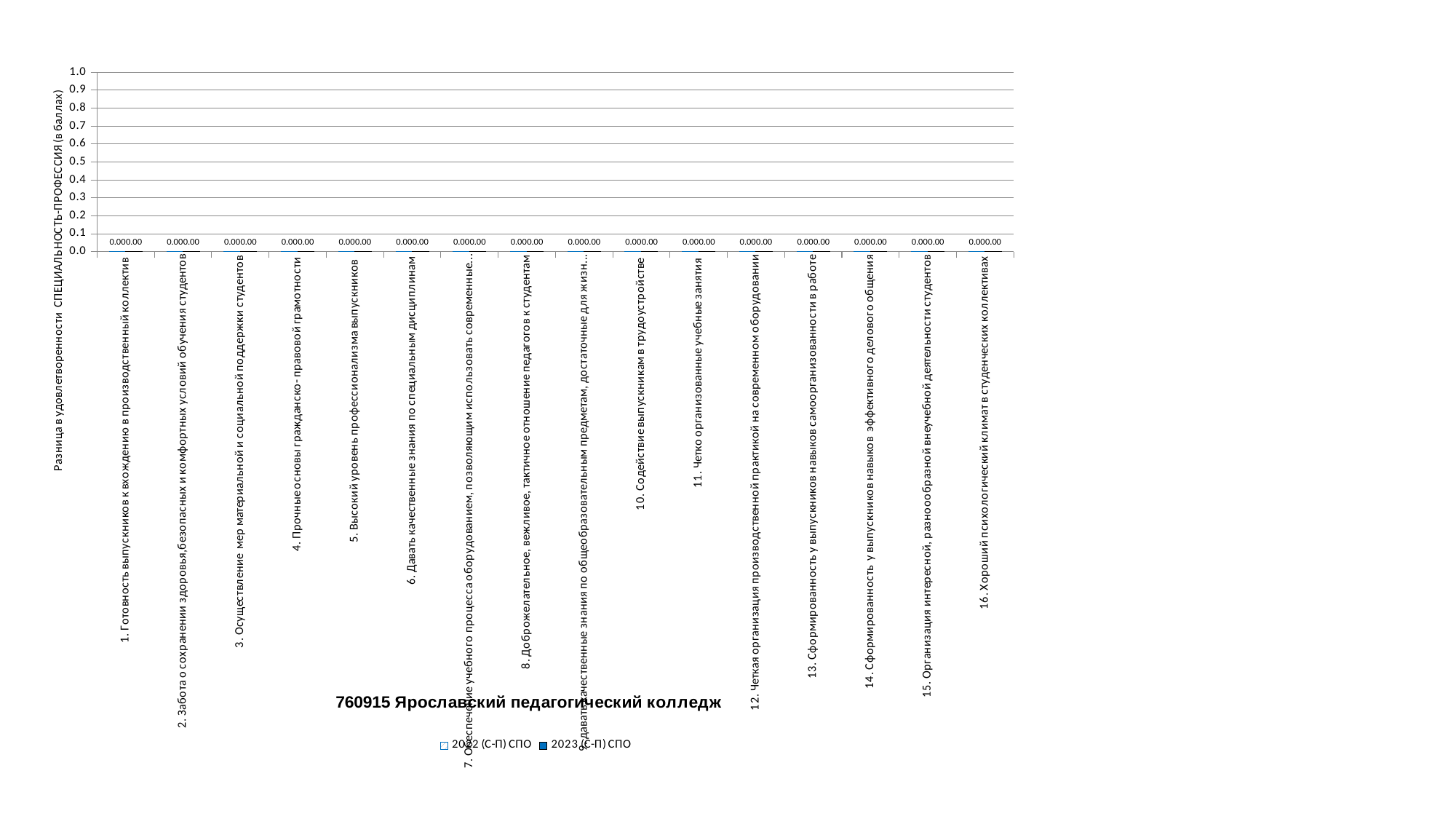
What is the data label printed for category "10. Содействие выпускникам в трудоустройстве"? 0.00 What is the title of the chart? 760915 Ярославский педагогический колледж How many series does the legend list? 2 Is the value for "11. Четко организованные учебные занятия" greater or less than 0.1? less How many categories are shown on the x axis? 16 What is the data label printed for category "16. Хороший психологический климат в студенческих коллективах"? 0.00 What kind of chart is this? bar chart What is the maximum value shown on the y axis? 1.0 Do the values rise, fall, or stay the same across the categories along the x axis? stay the same Is the value for "1. Готовность выпускников к вхождению в производственный коллектив" greater or less than 0.5? less What are the two series named in the legend? 2022 (С-П) СПО and 2023 (С-П) СПО